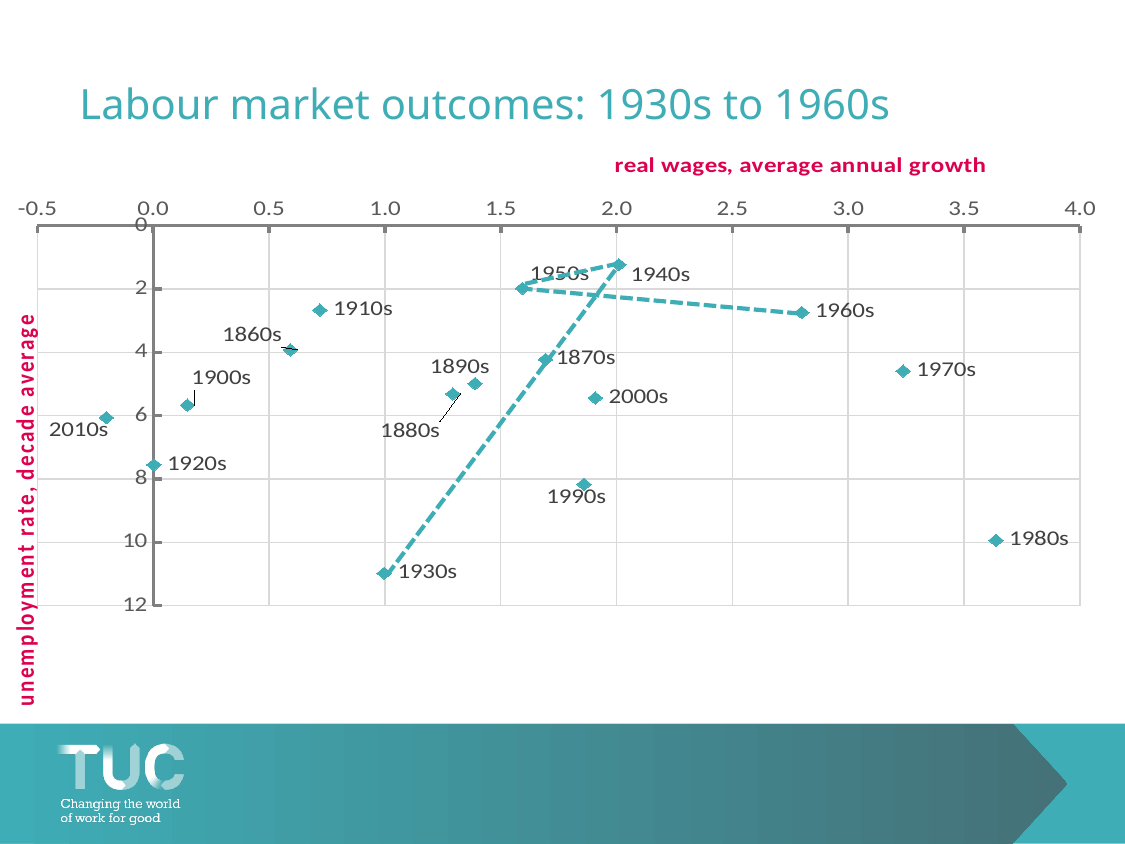
Which decade has the lowest real wage growth on the chart? 2010s Which decade has the lowest unemployment rate on the chart? 1940s Is the unemployment rate for the 1910s greater or less than 4? less What kind of chart is shown on the slide? scatter chart What is the title of the chart? Labour market outcomes: 1930s to 1960s What does the horizontal axis of the chart measure? real wages, average annual growth Is the unemployment rate for the 1980s greater or less than 8? greater Which decade has the highest real wage growth on the chart? 1980s Which decade has the highest unemployment rate on the chart? 1930s How many decades are plotted on the chart? 16 Which decade has the higher unemployment rate, the 1990s or the 2000s? 1990s Is the real wage growth for the 1960s greater or less than 2.5? greater